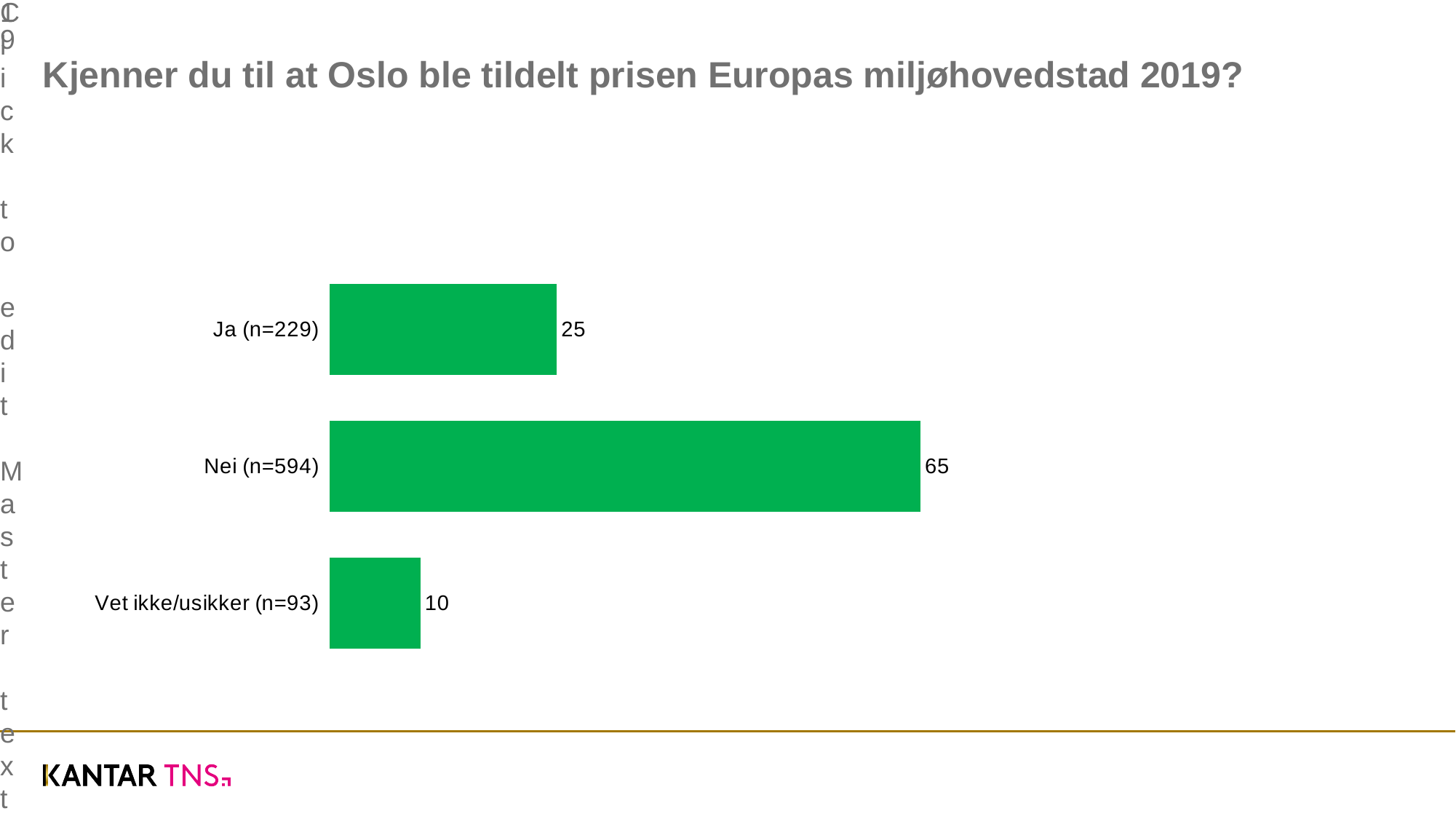
Which category has the highest value? Nei (n=594) What is the value for Nei (n=594)? 65 How many categories are shown in the chart? 3 What is the difference between the values for Nei (n=594) and Ja (n=229)? 40 Which is larger, the value for Ja (n=229) or the value for Vet ikke/usikker (n=93)? Ja (n=229) What is the value for Ja (n=229)? 25 What is the value for Vet ikke/usikker (n=93)? 10 What kind of chart is shown on the slide? Bar chart What colour are the bars in the chart? Green What is the title of the chart on the slide? Kjenner du til at Oslo ble tildelt prisen Europas miljøhovedstad 2019? Which category has the lowest value? Vet ikke/usikker (n=93) What is the difference between the values for Ja (n=229) and Vet ikke/usikker (n=93)? 15